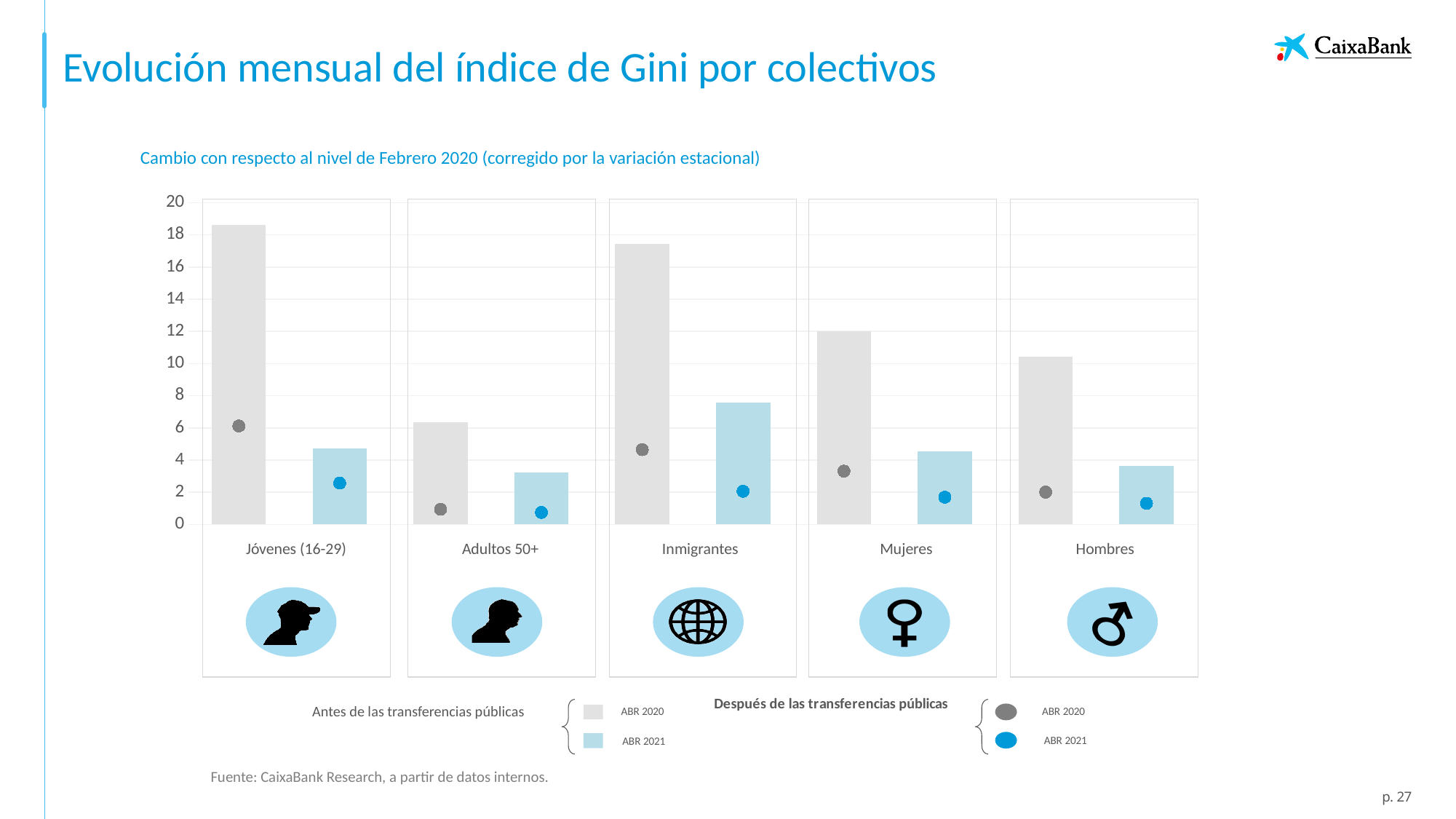
Which group has the highest ABR 2021 bar (antes de las transferencias públicas)? Inmigrantes How many groups (colectivos) are shown along the x axis of the chart? 5 Is the ABR 2020 bar for Mujeres (antes de las transferencias públicas) greater or less than 14? less What kind of chart is shown on the slide? Bar chart (with dot markers) How many entries does the legend of the chart list? 4 Is the ABR 2020 bar for Inmigrantes (antes de las transferencias públicas) greater or less than 16? greater Is the ABR 2021 bar for Adultos 50+ (antes de las transferencias públicas) greater or less than 4? less Which group has the highest ABR 2020 bar (antes de las transferencias públicas)? Jóvenes (16-29) Which group has the highest grey ABR 2020 dot (después de las transferencias públicas)? Jóvenes (16-29) Which group has the lowest ABR 2020 bar (antes de las transferencias públicas)? Adultos 50+ What colour represents ABR 2021 in the chart's legend? Blue Which is larger, the ABR 2020 bar for Mujeres or the ABR 2020 bar for Hombres (antes de las transferencias públicas)? Mujeres